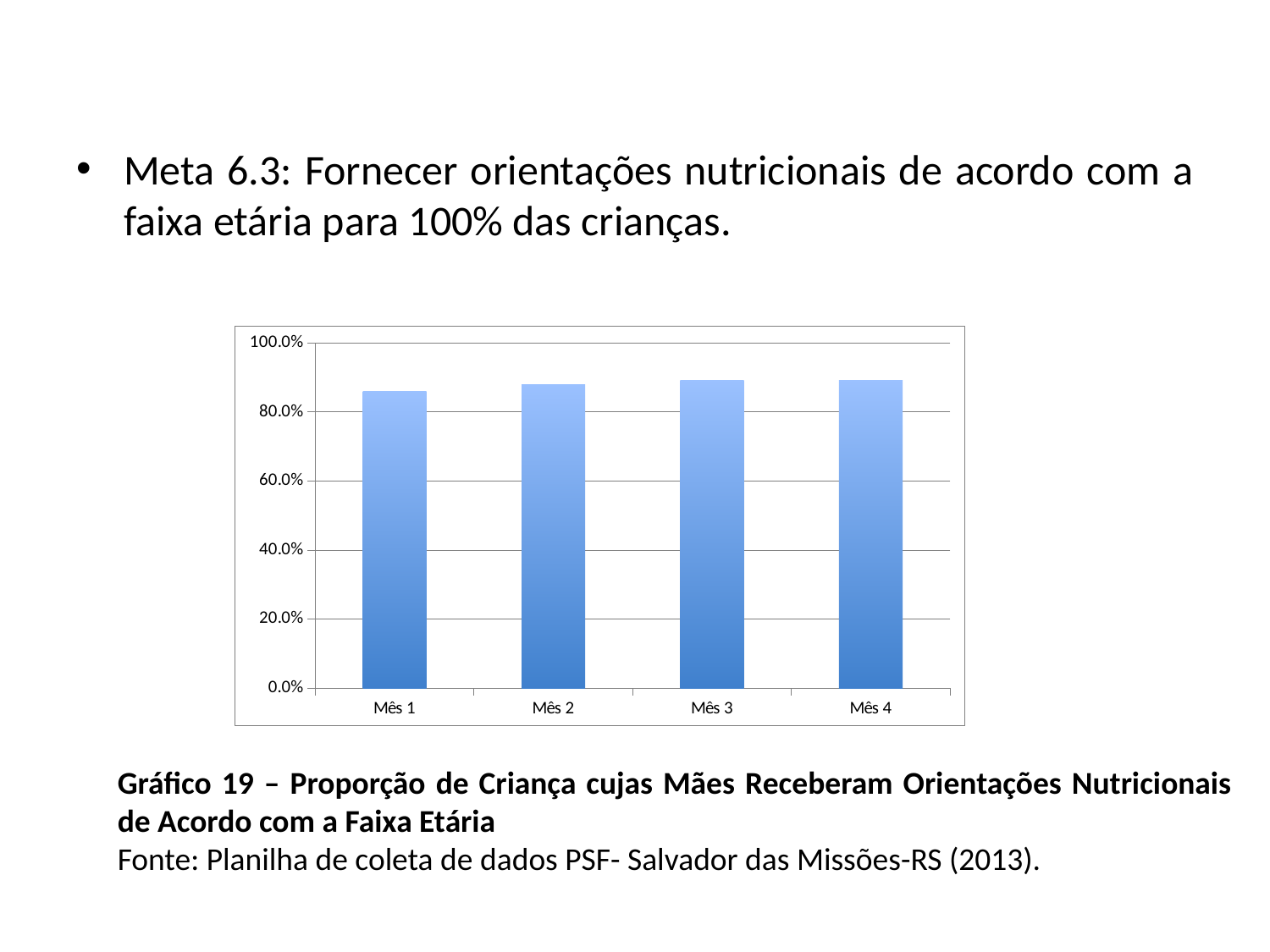
What is the highest value shown on the y axis of the chart? 100.0% Is the value for Mês 4 greater or less than 80.0%? greater How many categories (months) are plotted on the x axis of the chart? 4 What is the label of the first category on the x axis? Mês 1 Is the value for Mês 3 greater or less than 100.0%? less Which is larger, the value for Mês 1 or the value for Mês 3? Mês 3 Do the values generally rise or fall from Mês 1 to Mês 4? rise Which month has the lowest bar in the chart? Mês 1 Is the value for Mês 2 greater or less than 60.0%? greater What kind of chart is shown on the slide? bar chart